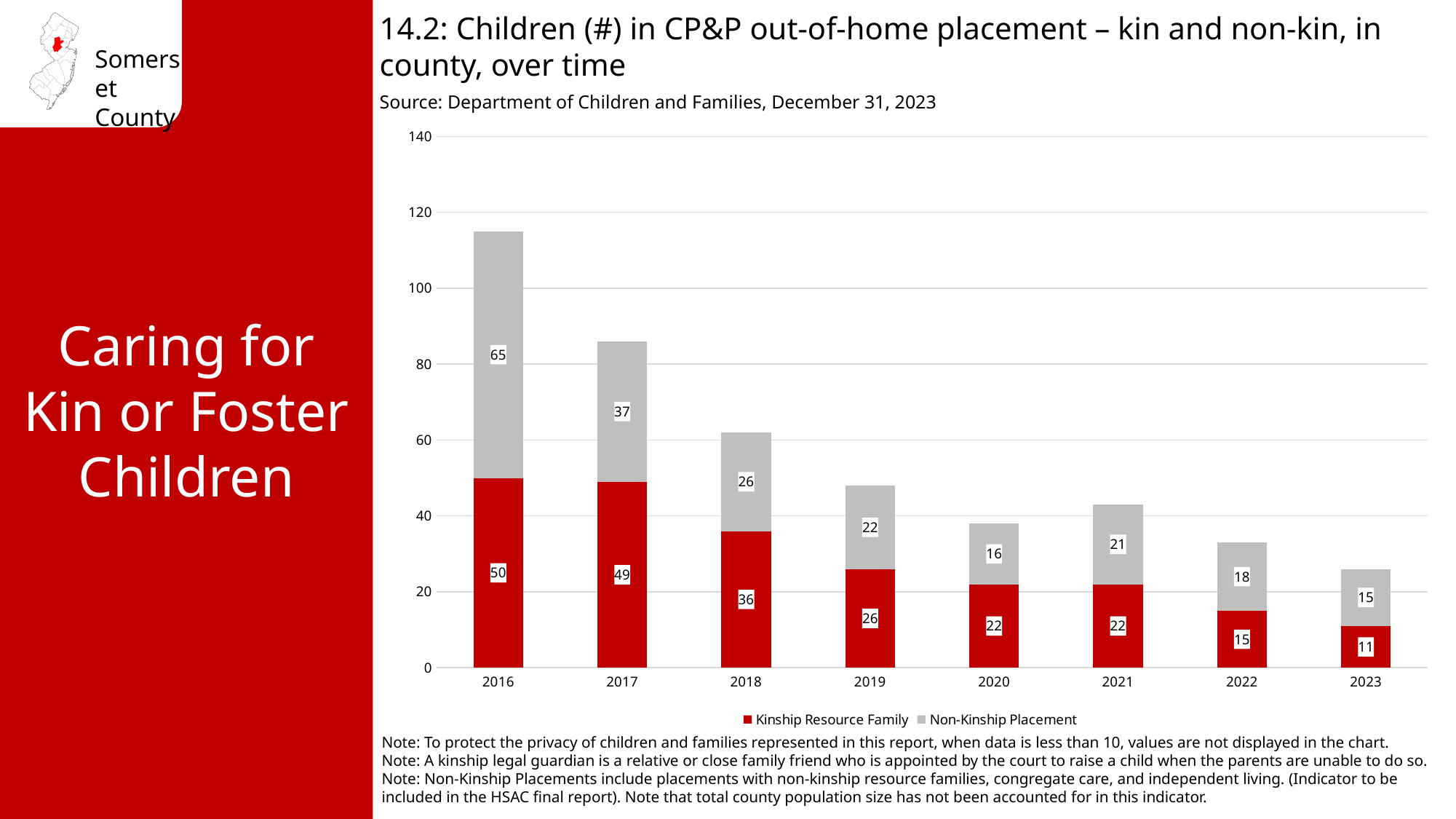
What is the Kinship Resource Family value for 2018? 36 How many series does the legend list? 2 Which year has the lowest Kinship Resource Family value? 2023 What is the Non-Kinship Placement value for 2021? 21 Do the total bar heights generally rise or fall from 2016 to 2023? Fall What is the total of the stacked bar for 2023? 26 What is the total number of children in out-of-home placement in 2016 (both segments combined)? 115 In 2022, which is larger: Kinship Resource Family or Non-Kinship Placement? Non-Kinship Placement What is the difference between the Kinship Resource Family values for 2016 and 2017? 1 How many years are shown on the x axis? 8 Which year has the highest Non-Kinship Placement value? 2016 What type of chart is shown on the slide? Stacked bar chart